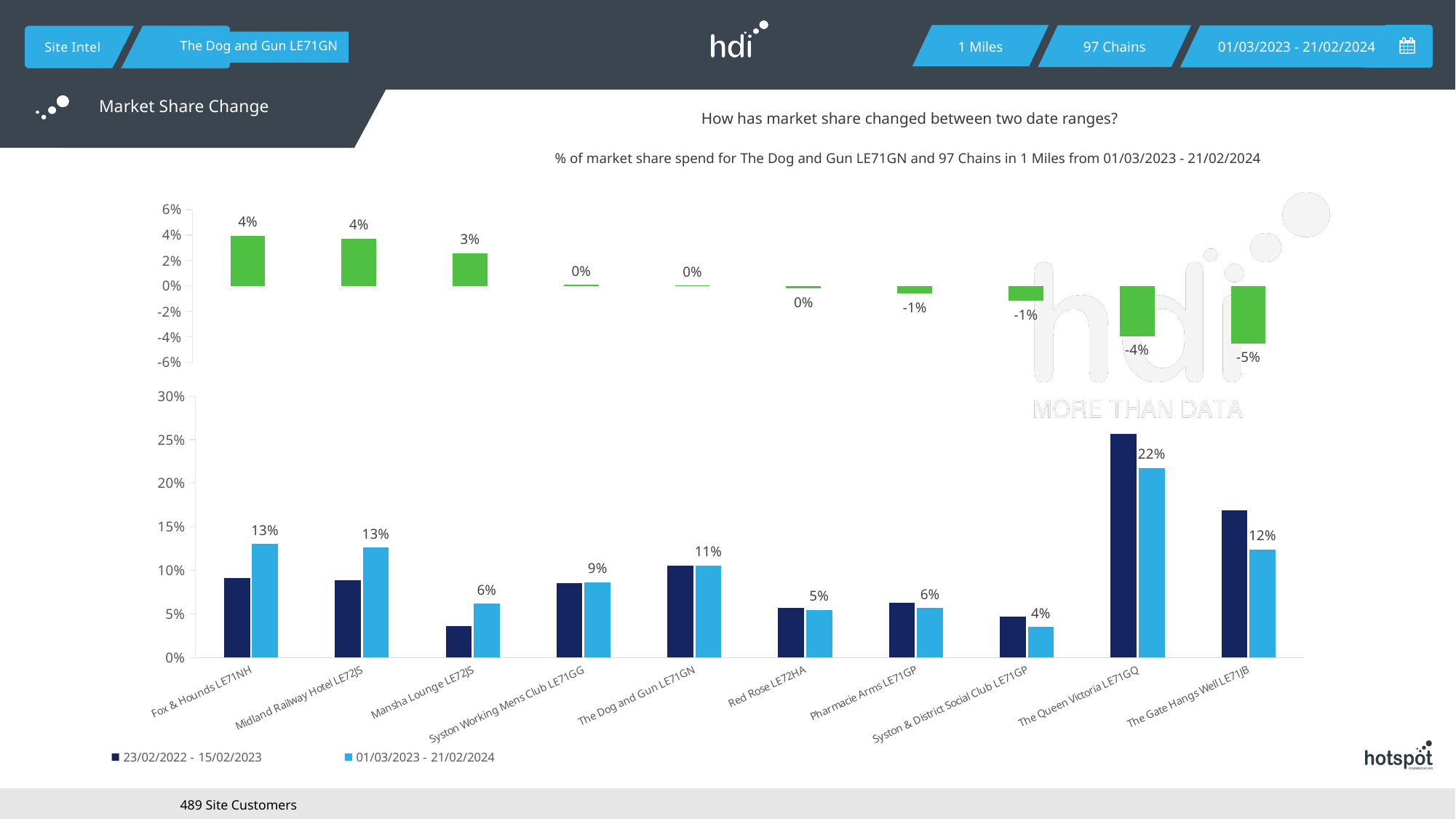
In the top chart (market share change), what is the value for The Gate Hangs Well LE71JB? -5% How many categories are shown on the x axis of the bottom chart? 10 How many series does the legend of the bottom chart list? 2 In the bottom chart, what is the 01/03/2023 - 21/02/2024 value for The Queen Victoria LE71GQ? 22% In the top chart (market share change), which category has the lowest value? The Gate Hangs Well LE71JB What type of chart is the bottom chart? Bar chart In the top chart (market share change), what is the value for Fox & Hounds LE71NH? 4% In the bottom chart, is the 23/02/2022 - 15/02/2023 value for The Gate Hangs Well LE71JB greater or less than 15%? greater In the bottom chart, what is the difference between the 01/03/2023 - 21/02/2024 values for The Queen Victoria LE71GQ and Syston & District Social Club LE71GP? 18% In the bottom chart, what is the 01/03/2023 - 21/02/2024 value for The Dog and Gun LE71GN? 11% In the bottom chart, which category has the highest 01/03/2023 - 21/02/2024 value? The Queen Victoria LE71GQ In the bottom chart, which has the larger 01/03/2023 - 21/02/2024 value: Syston Working Mens Club LE71GG or Red Rose LE72HA? Syston Working Mens Club LE71GG